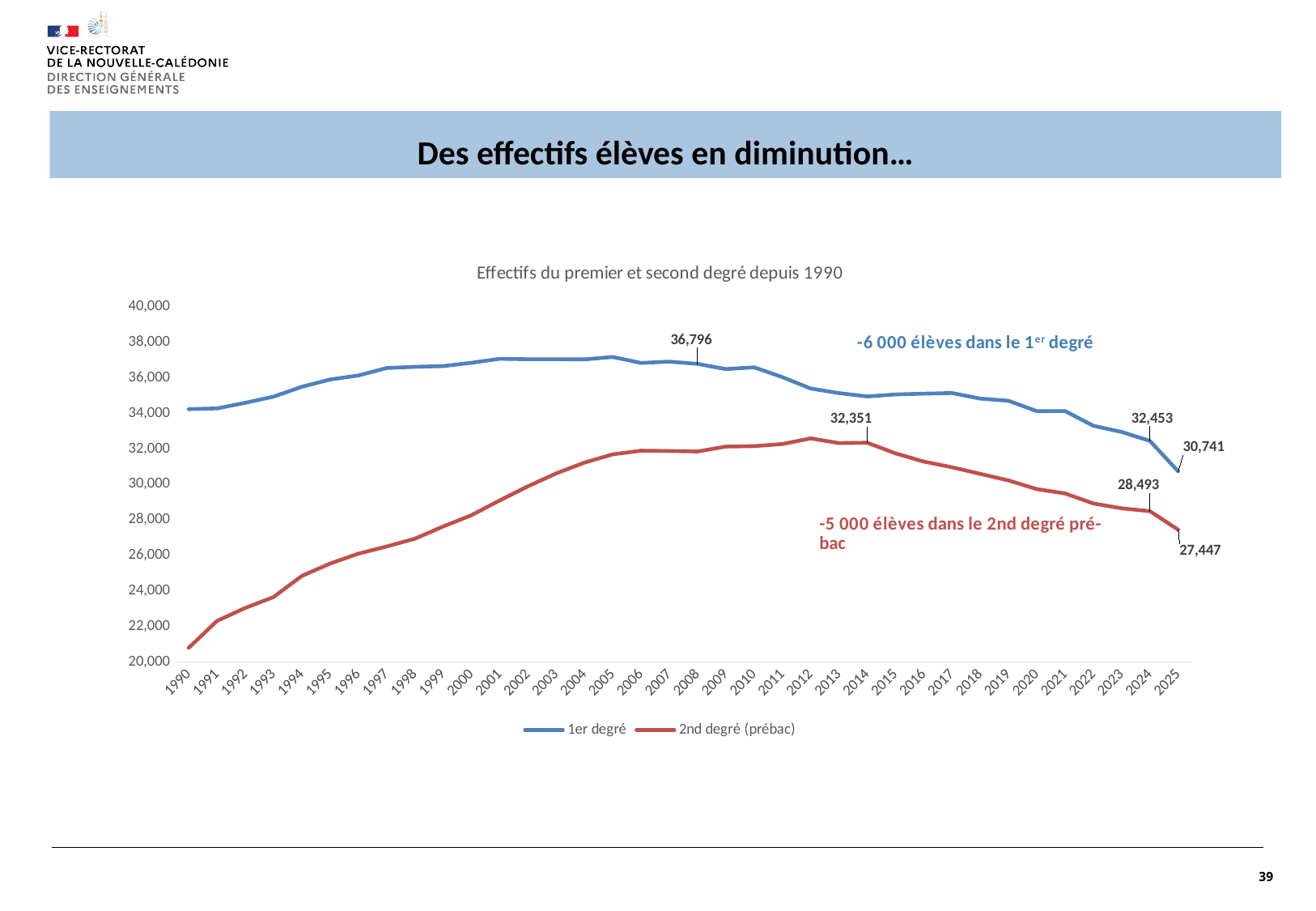
By how much did the 1er degré value fall between 2024 and 2025? 1,712 In 2025, which series has the larger value, 1er degré or 2nd degré (prébac)? 1er degré What kind of chart is shown on the slide? line chart Is the value for 2nd degré (prébac) in 1990 greater or less than 22,000? less What is the title of the chart? Effectifs du premier et second degré depuis 1990 What is the labelled value for 2nd degré (prébac) in 2014? 32,351 What is the value for 2nd degré (prébac) in 2025? 27,447 By how much did the 2nd degré (prébac) value fall between 2024 and 2025? 1,046 What is the value for 2nd degré (prébac) in 2024? 28,493 What is the value for 1er degré in 2025? 30,741 What is the value for 1er degré in 2024? 32,453 How many series does the legend list? 2